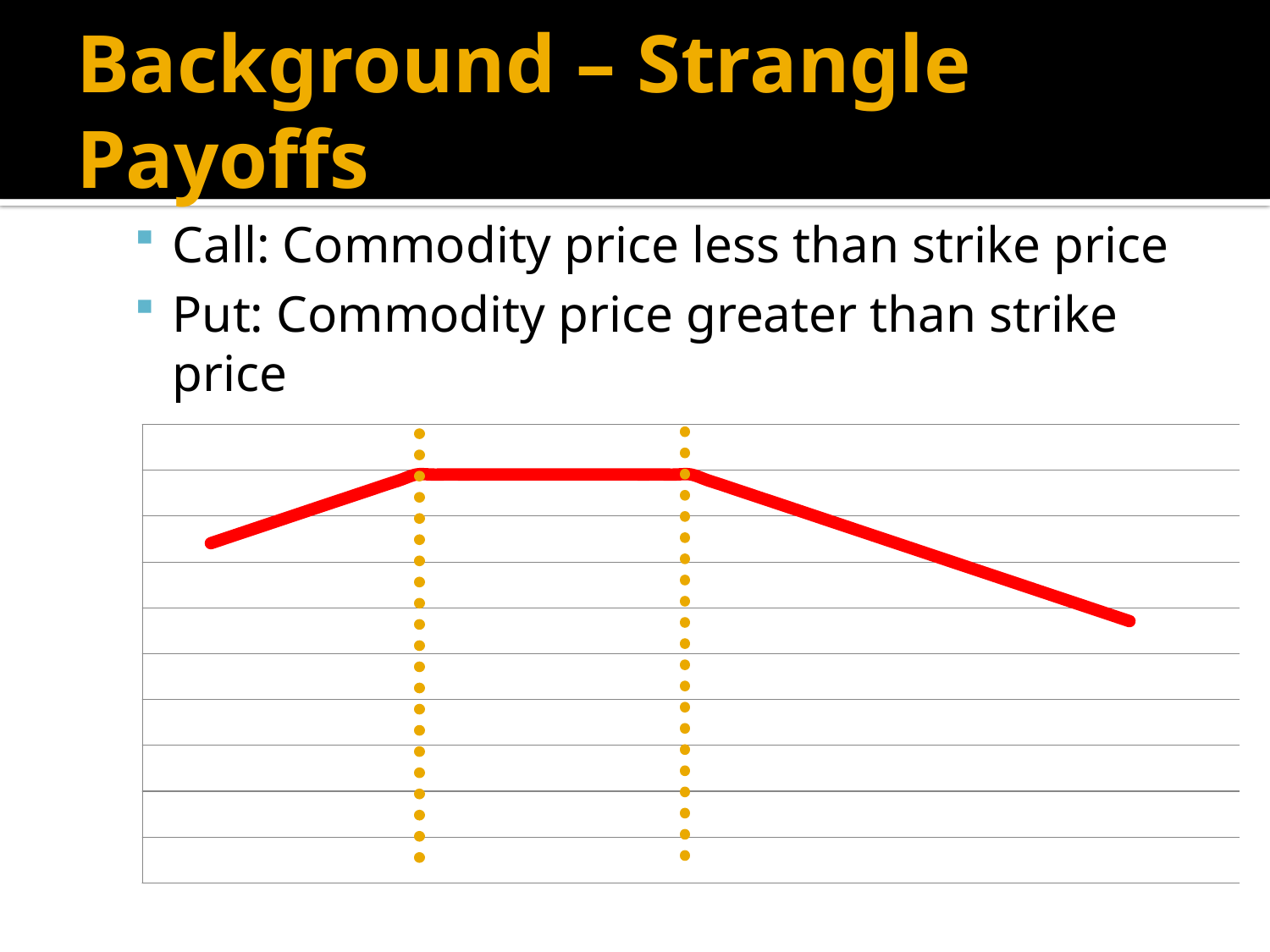
Between the two dotted vertical lines, is the red line rising, falling, or flat? flat Which end of the red line is lower: the left end or the right end? the right end Where does the red line reach its highest level: left of the first dotted line, between the two dotted lines, or right of the second dotted line? between the two dotted lines What kind of chart is shown on the slide? line chart To the left of the first dotted vertical line, does the red line rise or fall as it moves to the right? rise To the right of the second dotted vertical line, does the red line rise or fall as it moves to the right? fall How many dotted vertical lines are drawn on the chart? 2 What colour is the plotted line on the chart? red